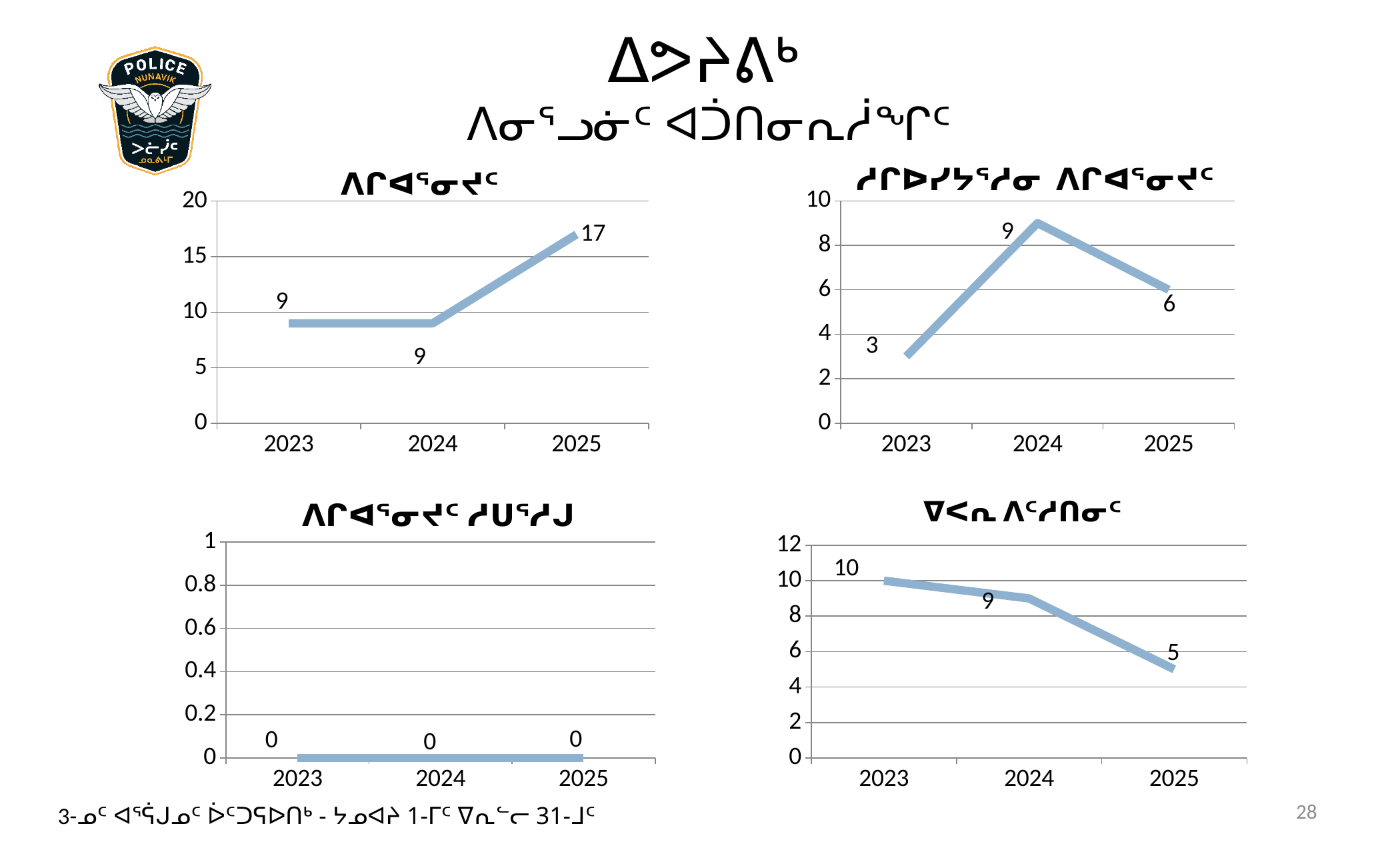
In the top-left chart, what is the value for 2023? 9 In the bottom-right chart, is the value for 2024 larger or smaller than the value for 2025? larger In the bottom-right chart, do the values rise or fall from 2023 to 2025? fall In the bottom-right chart, what is the difference between the 2023 and 2025 values? 5 In the top-right chart, what is the value for 2025? 6 In the bottom-right chart, what is the value for 2023? 10 In the top-left chart, what is the difference between the 2025 and 2024 values? 8 In the bottom-left chart, what is the value for 2024? 0 In the top-right chart, which year has the highest value? 2024 In the top-left chart, what is the value for 2025? 17 In the top-right chart, which year has the lowest value? 2023 What kind of chart is the top-right chart? line chart